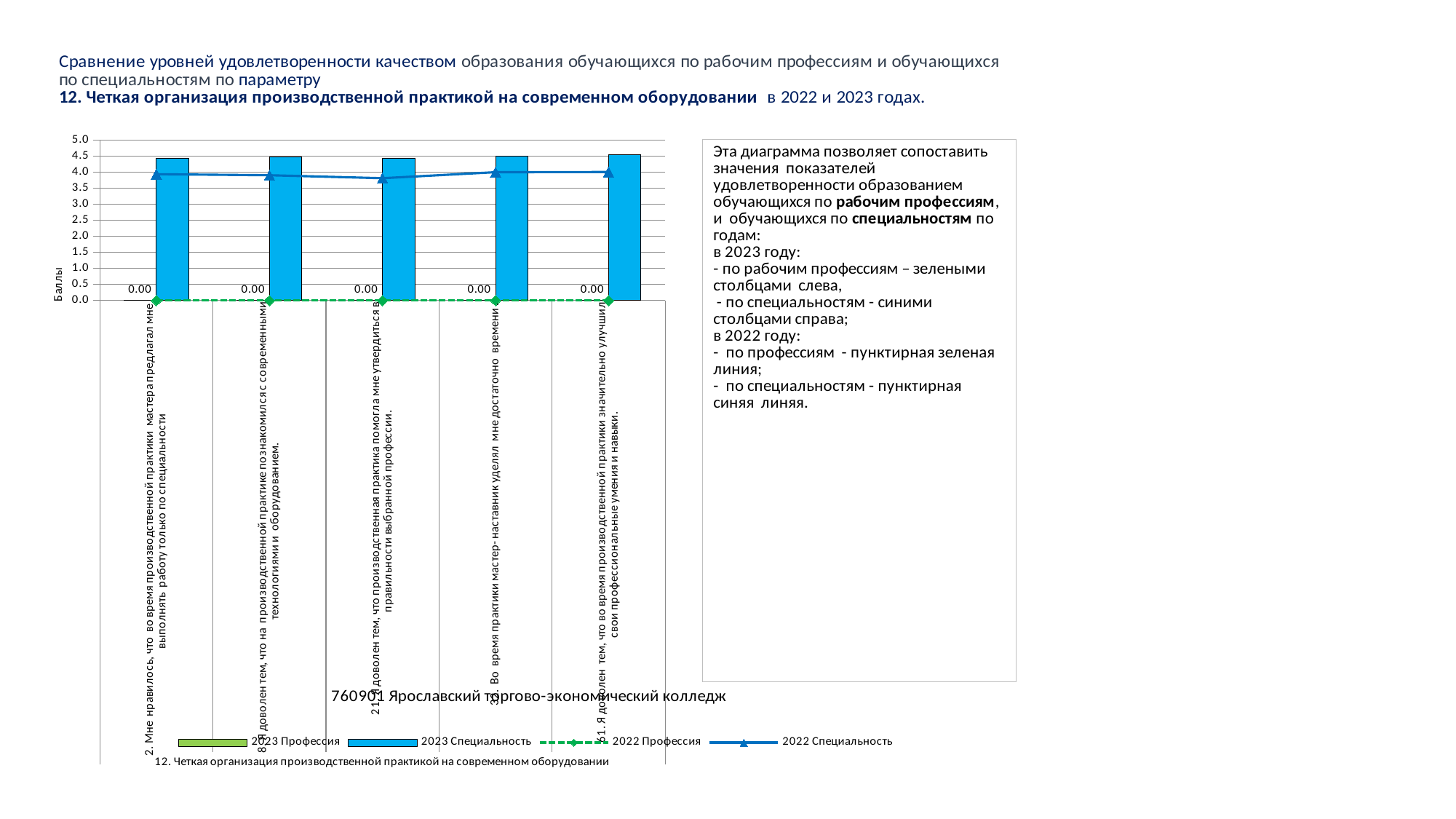
What colour are the 2023 Специальность bars in the chart? Blue How many series does the chart legend list? 4 Which category has the lowest 2022 Специальность value? 21. Я доволен тем, что производственная практика помогла мне утвердиться в правильности выбранной профессии How many categories are plotted along the x axis of the chart? 5 Is the 2023 Специальность value for category 8 (Я доволен тем, что на производственной практике познакомился с современными технологиями и оборудованием) greater or less than 4.0? greater For category 8, which is larger: the 2023 Специальность value or the 2022 Специальность value? 2023 Специальность What is the title of the vertical axis of the chart? Баллы What value is printed as the data label at the base of each category in the chart? 0.00 Does the 2022 Профессия line rise, fall or stay flat across the categories? Stays flat What kind of chart is shown on the slide? A combined bar and line chart Is the 2023 Специальность value for category 2 (Мне нравилось, что во время производственной практики мастера предлагал мне выполнять работу только по специальности) greater or less than 4.0? greater Is the 2022 Специальность value for category 21 (Я доволен тем, что производственная практика помогла мне утвердиться в правильности выбранной профессии) greater or less than 4.0? less